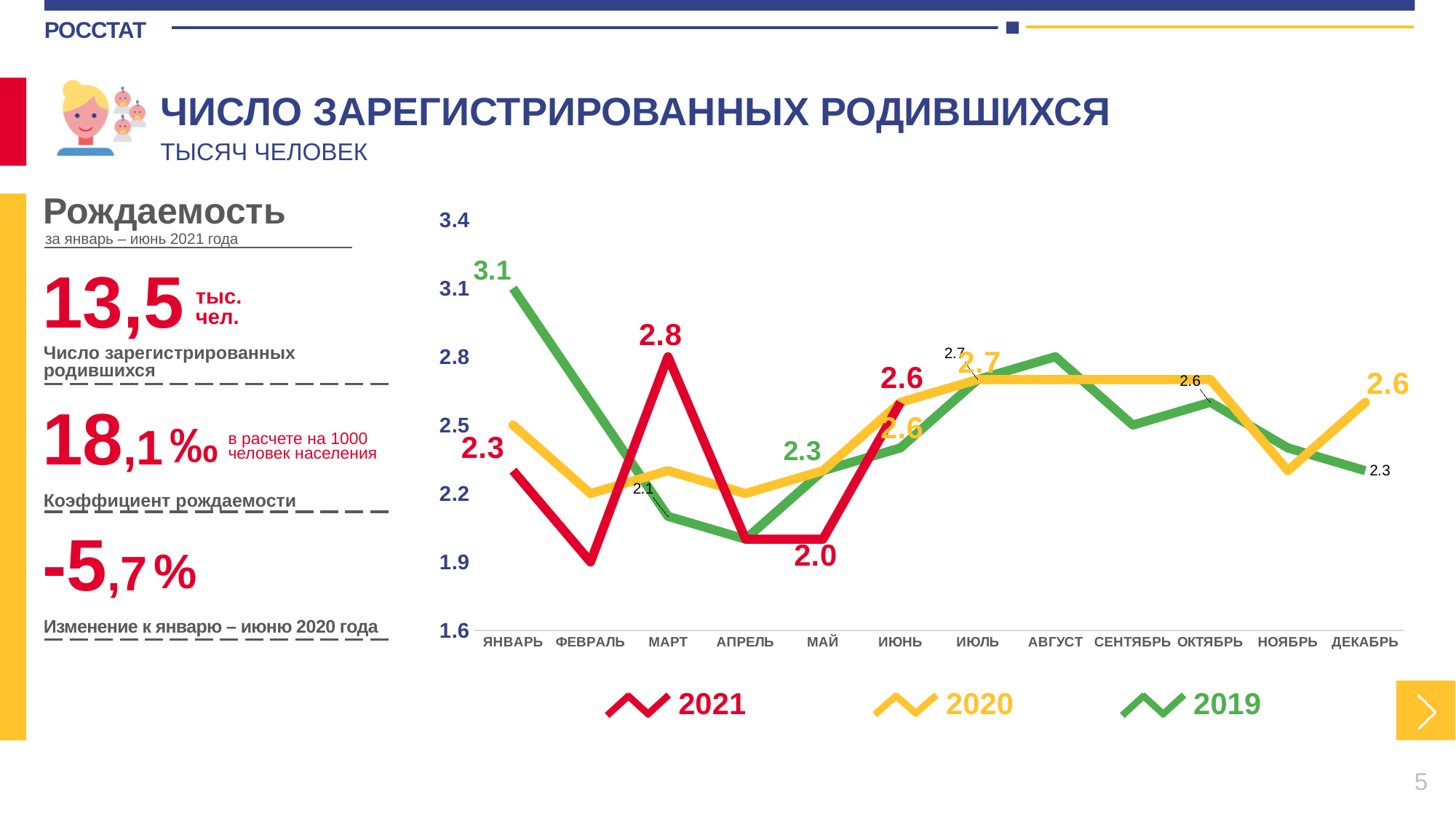
Which series has the larger value in January: 2019 or 2021? 2019 How many series does the legend list? 3 What is the value for 2020 in December (ДЕКАБРЬ)? 2.6 What is the difference between the 2021 values for March and May? 0.8 Is the value for 2021 in February (ФЕВРАЛЬ) greater or less than 2.2? less What is the value for 2021 in May (МАЙ)? 2.0 In which month does the 2021 line reach its highest value? МАРТ What is the value for 2019 in January (ЯНВАРЬ)? 3.1 What kind of chart is shown on the slide? line chart What is the value for 2021 in March (МАРТ)? 2.8 What is the value for 2021 in January (ЯНВАРЬ)? 2.3 How many months are shown along the x axis? 12